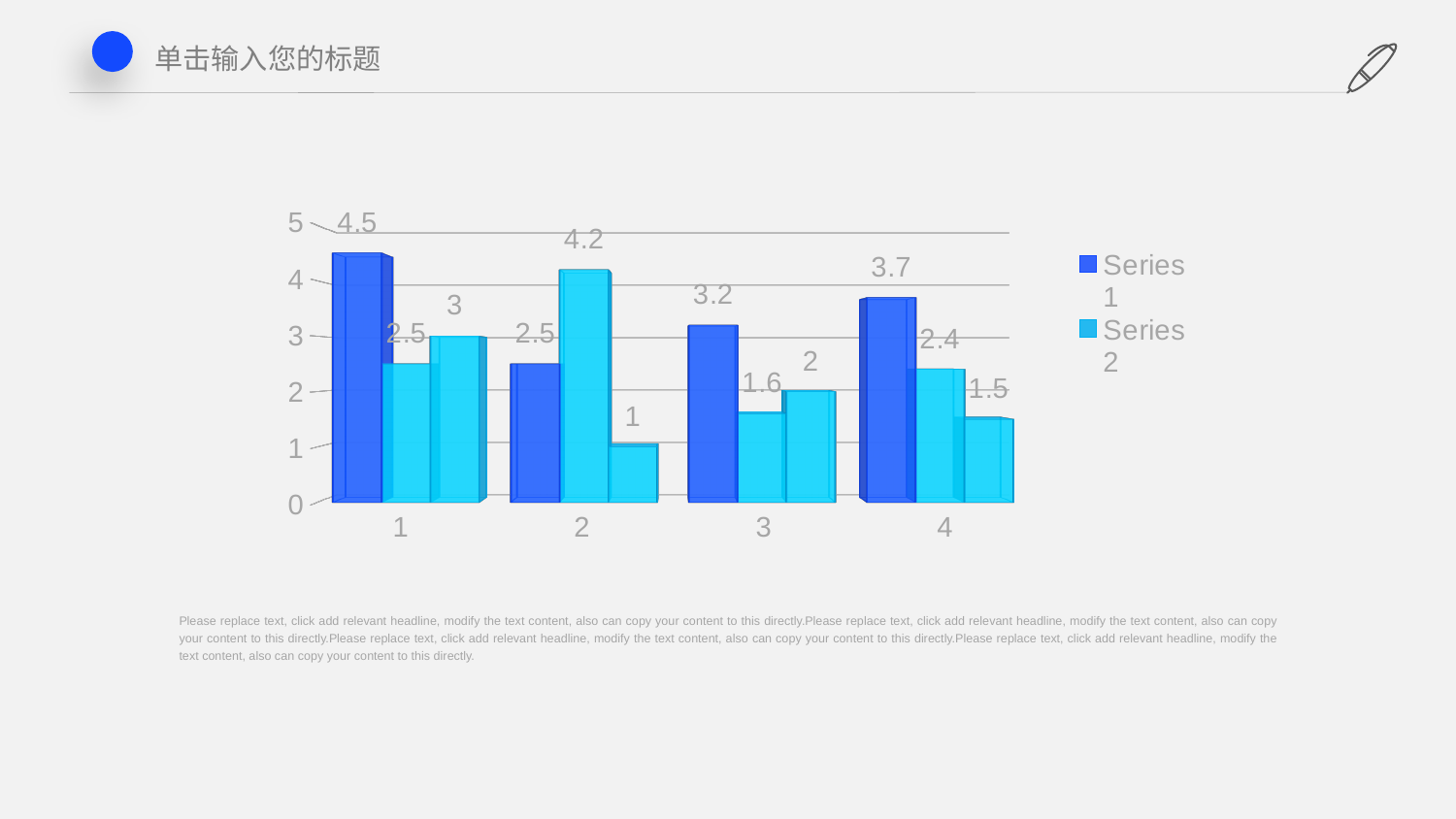
How many categories are shown on the x axis? 4 What is the value of Series 1 for category 3? 3.2 What is the difference between the Series 1 values for category 1 and category 4? 0.8 What kind of chart is shown on the slide? bar chart In category 2, which is larger, Series 1 or Series 2? Series 2 Which category has the lowest value for Series 1? 2 Which category has the lowest value for Series 2? 3 What is the value of Series 2 for category 4? 2.4 What is the value of Series 1 for category 1? 4.5 What is the value of Series 2 for category 2? 4.2 Which category has the highest value for Series 1? 1 How many series does the legend list? 2